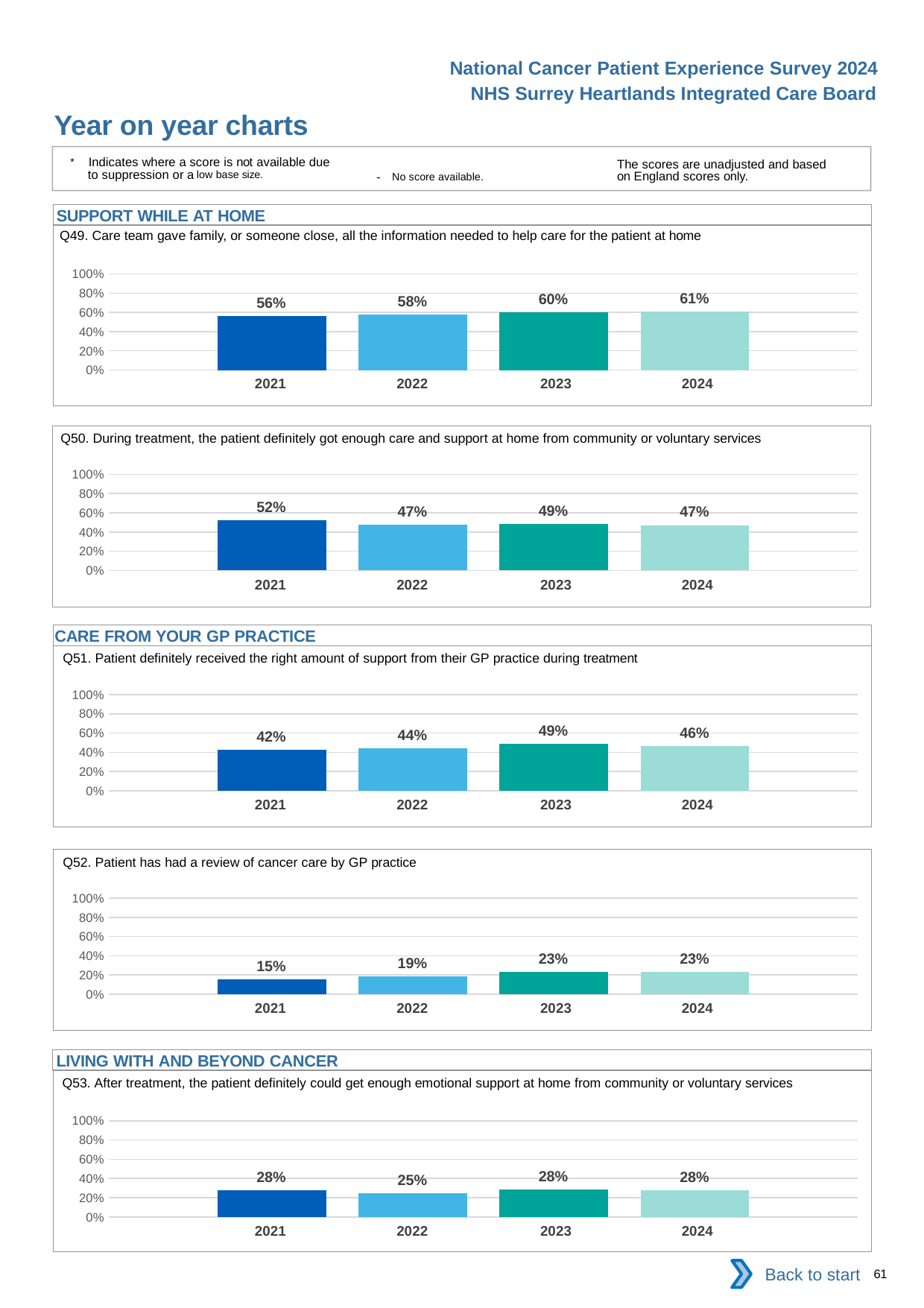
How many bars are plotted in the Q53 chart? 4 In the Q50 chart, what is the difference between the 2021 and 2024 values? 5% In the Q51 chart, which year has the highest value? 2023 What kind of chart is used for Q50? bar chart In the Q49 chart, which year has the lowest value? 2021 In the Q53 chart, which year has the lowest value? 2022 In the Q52 chart, what is the value for 2021? 15% In the Q51 chart, is the value for 2023 larger or smaller than the value for 2024? larger In the Q49 chart, do the values rise or fall from 2021 to 2024? rise In the Q52 chart, what is the difference between the 2023 and 2021 values? 8% In the Q49 chart, what is the value for 2024? 61% In the Q50 chart, what is the value for 2021? 52%